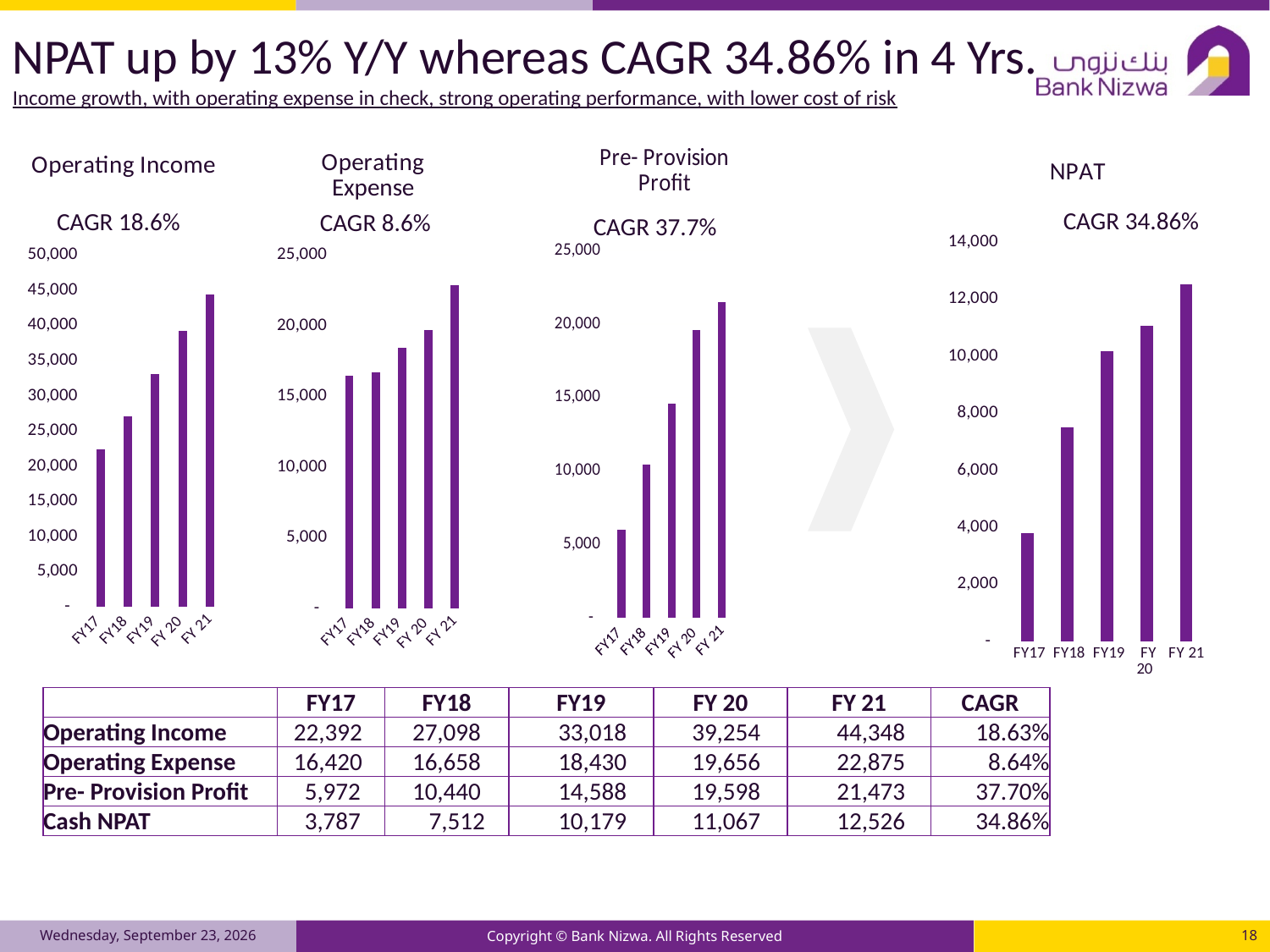
How many fiscal years are plotted in the NPAT chart? 5 Do the values in the NPAT chart rise or fall from FY17 to FY 21? rise What CAGR is shown above the Pre-Provision Profit chart? CAGR 37.7% According to the table on the slide, what is the Operating Income value for FY 20? 39,254 In the NPAT chart, is the value for FY17 greater or less than 4,000? less In the Pre-Provision Profit chart, is the value for FY18 greater or less than 10,000? greater What kind of chart is the Operating Income chart? bar chart In the Operating Income chart, which is larger, the value for FY18 or the value for FY19? FY19 In the Pre-Provision Profit chart, which fiscal year has the lowest value? FY17 In the Operating Income chart, which fiscal year has the highest value? FY 21 In the Operating Expense chart, is the value for FY 21 greater or less than 20,000? greater According to the table on the slide, what is the Cash NPAT value for FY 21? 12,526